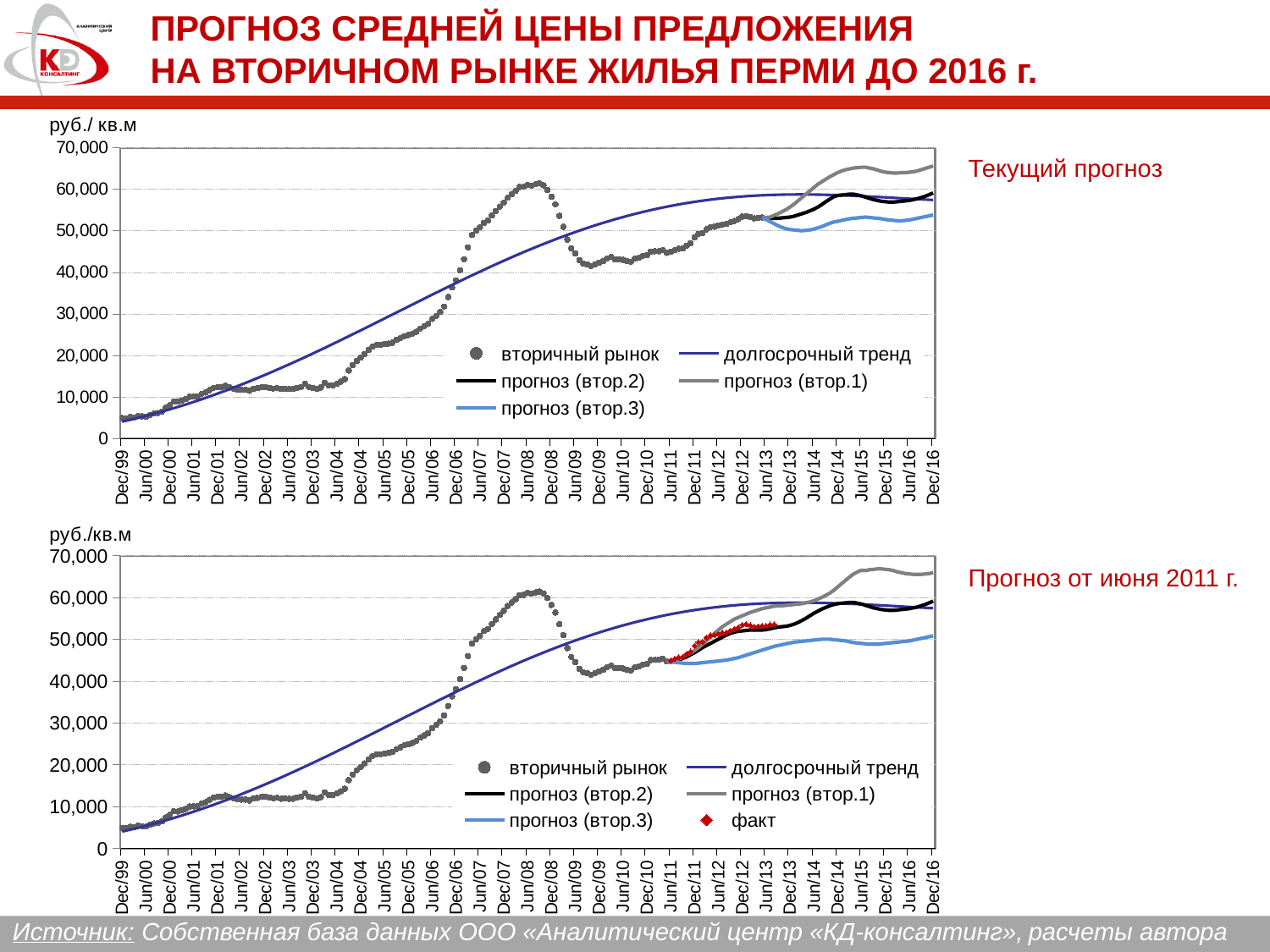
Which series appears only in the legend of the bottom chart (Прогноз от июня 2011 г.) and not in the top chart? факт In the top chart (Текущий прогноз), is the value of прогноз (втор.1) at Dec/16 greater or less than 60,000? greater How many series does the legend of the top chart (Текущий прогноз) list? 5 In the bottom chart (Прогноз от июня 2011 г.), is the peak of вторичный рынок around Jun/08 greater or less than 50,000? greater In the top chart (Текущий прогноз), does the долгосрочный тренд line rise or fall from Dec/99 to Dec/16? rises How many series does the legend of the bottom chart (Прогноз от июня 2011 г.) list? 6 In the bottom chart (Прогноз от июня 2011 г.), which forecast series reaches the highest value at Dec/16? прогноз (втор.1) What kind of chart is the top chart (Текущий прогноз)? line chart In the bottom chart (Прогноз от июня 2011 г.), is the value of прогноз (втор.3) at Dec/16 greater or less than 60,000? less In the top chart (Текущий прогноз), which series is higher at Dec/16: прогноз (втор.1) or прогноз (втор.3)? прогноз (втор.1) What unit is shown on the vertical axis of the top chart (Текущий прогноз)? руб./ кв.м